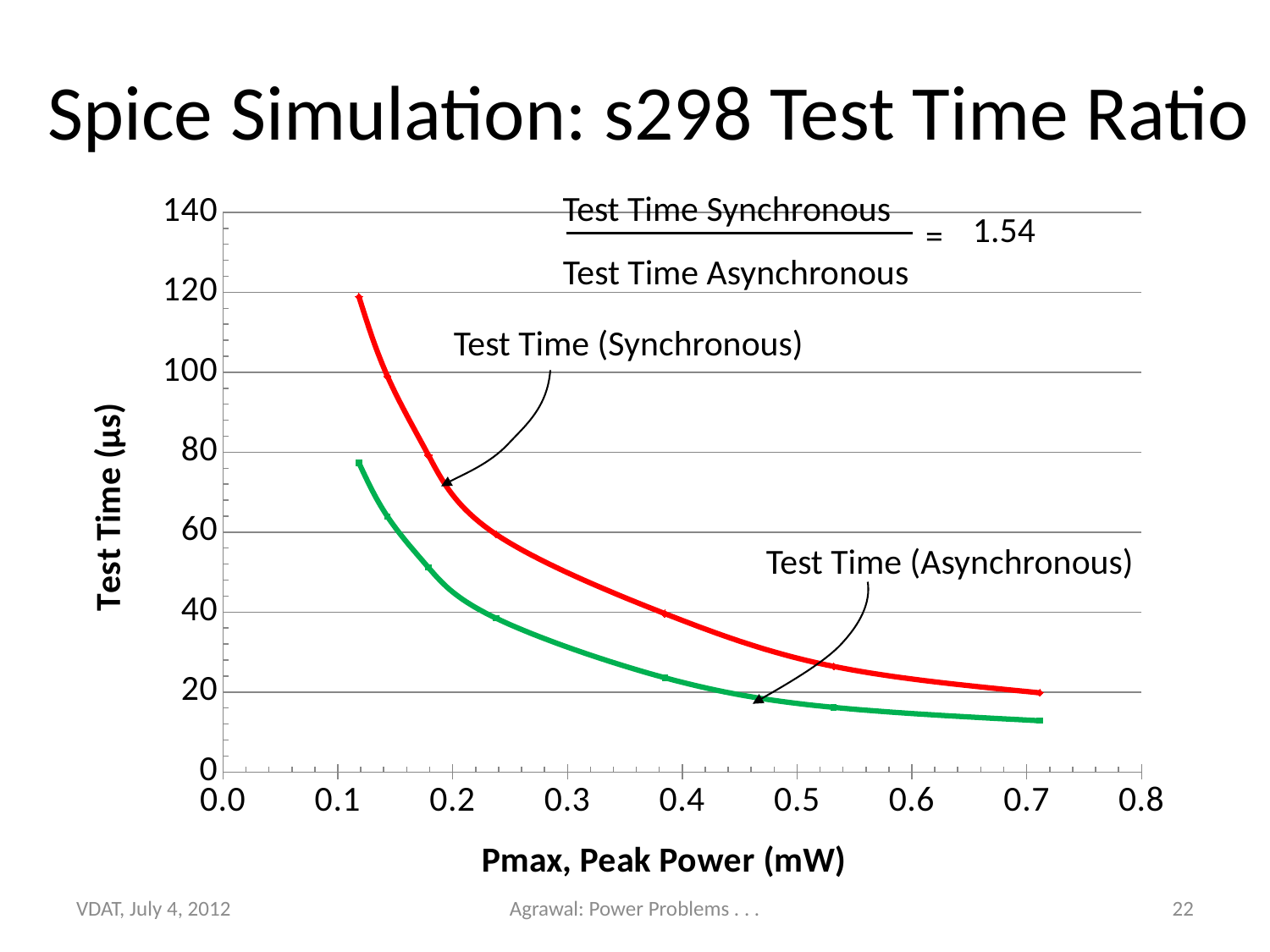
Is the Test Time (Synchronous) value at the lowest plotted Pmax greater or less than 100? greater What is the label of the x axis? Pmax, Peak Power (mW) Does the Test Time (Synchronous) curve rise or fall as Pmax increases? fall Is the Test Time (Asynchronous) value at Pmax of 0.7 mW greater or less than 20? less How many data series are plotted on the chart? 2 Does the Test Time (Asynchronous) curve rise or fall as Pmax increases? fall What is the ratio of Test Time Synchronous to Test Time Asynchronous stated on the slide? 1.54 Is the Test Time (Synchronous) value at Pmax of 0.4 mW greater or less than 60? less What kind of chart is shown on the slide? line chart Which series has the higher test time at a peak power of 0.3 mW, Synchronous or Asynchronous? Synchronous